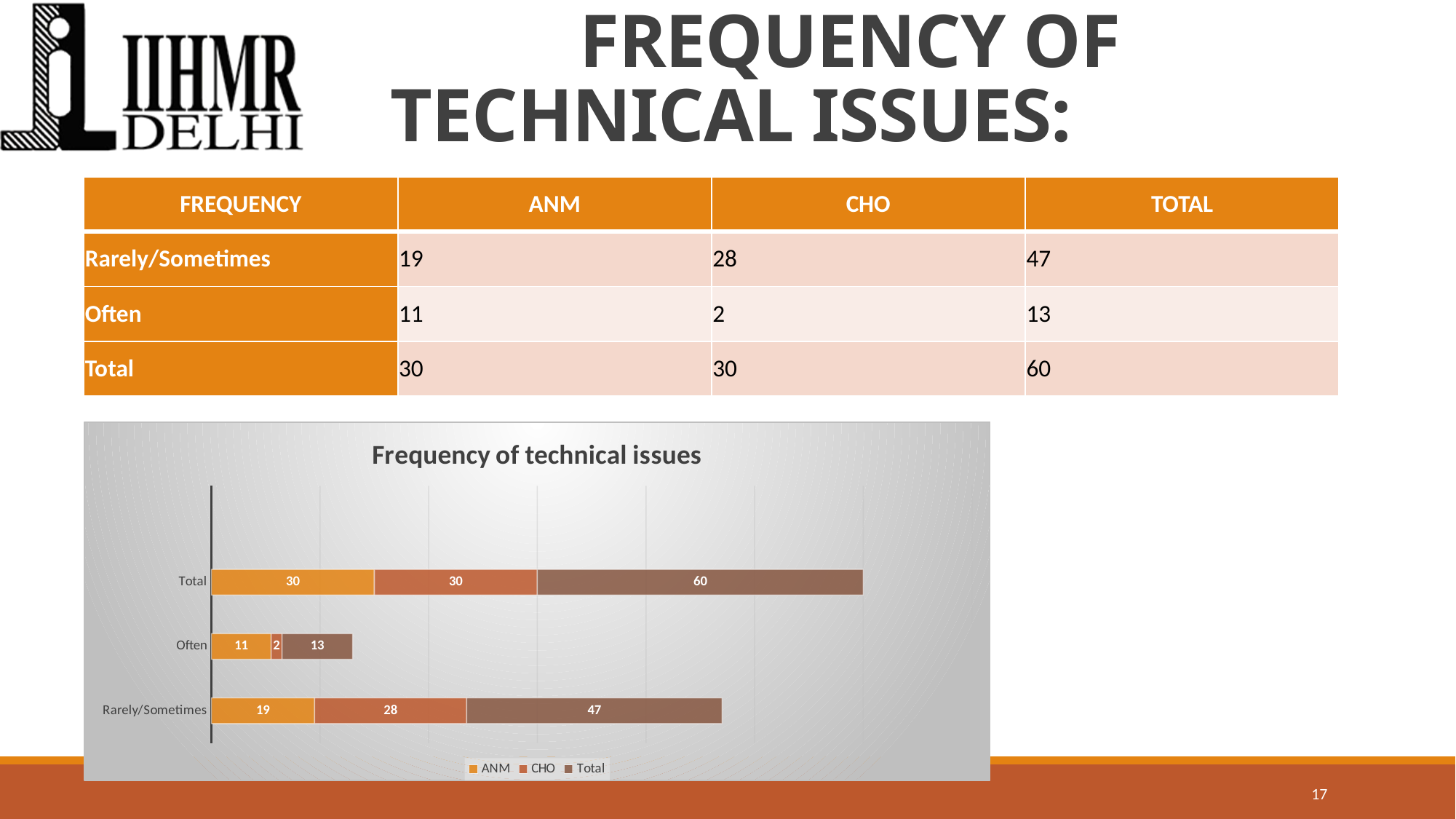
Which category has the highest CHO value in the chart? Total Is the ANM value for Rarely/Sometimes larger or smaller than the CHO value for Rarely/Sometimes? smaller What is the title of the chart? Frequency of technical issues How many categories are shown on the chart's axis? 3 What is the combined length of the stacked bar for Often (sum of all three segments)? 26 Which category has the lowest ANM value in the chart? Often What is the CHO value for Often in the chart? 2 What kind of chart is shown on the slide? stacked bar chart What is the ANM value for Rarely/Sometimes in the chart? 19 What is the difference between the CHO values for Rarely/Sometimes and Often? 26 What is the Total series value for the Total category in the chart? 60 How many series does the chart legend list? 3